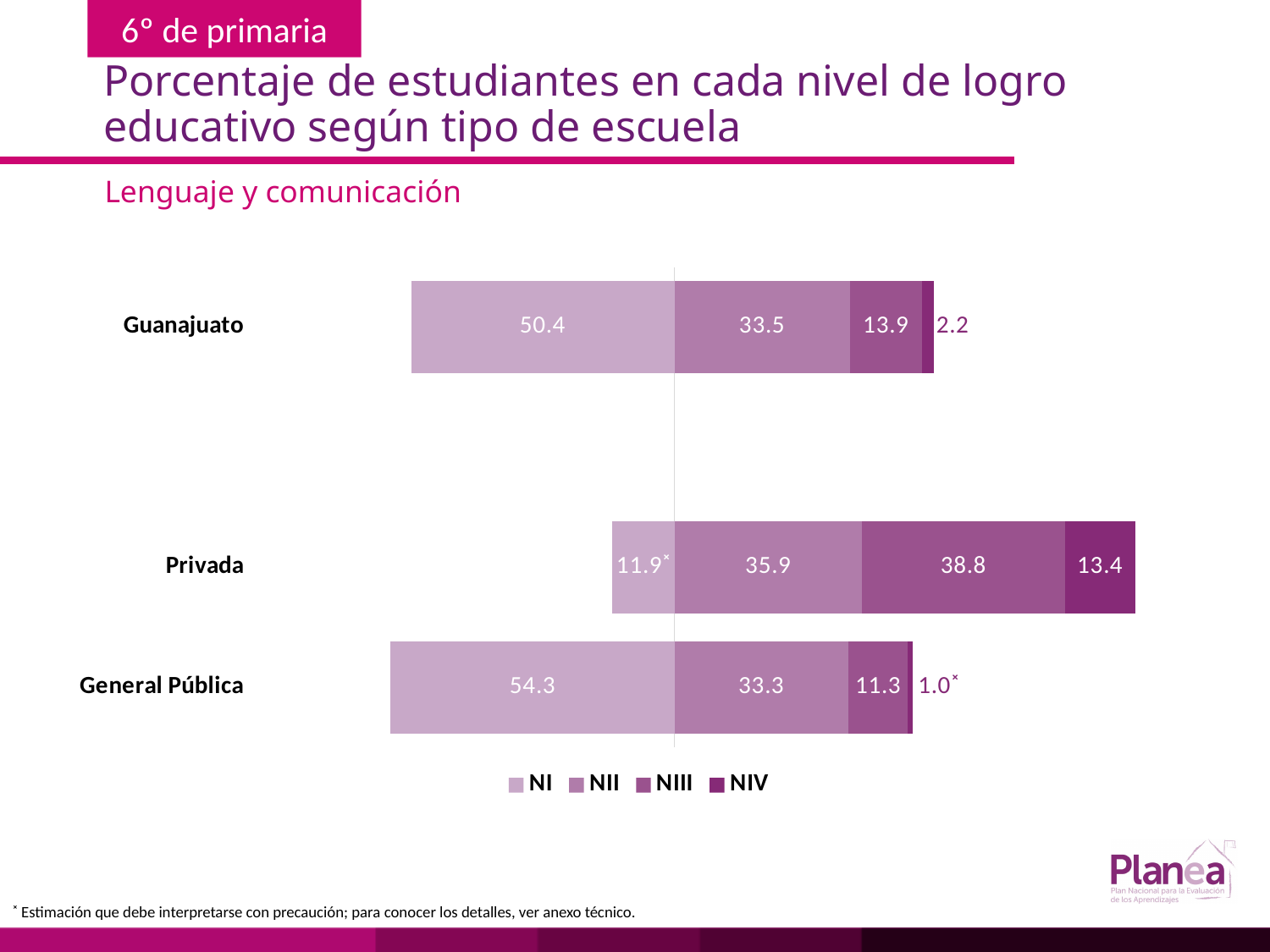
Which subject area does the chart cover, according to the subtitle? Lenguaje y comunicación What is the NIII value for General Pública? 11.3 Which is larger, the NIII value for Privada or the NIII value for Guanajuato? Privada What kind of chart is shown on the slide? Stacked bar chart Which school type has the highest NI value? General Pública Which category has the lowest NIV value? General Pública What percentage of Guanajuato students are at level NI? 50.4 What is the difference between the NI values for General Pública and Privada? 42.4 What is the total of the stacked bar for Guanajuato? 100.0 How many categories (school types) are shown in the chart? 3 What is the NIV value for Privada schools? 13.4 How many series does the legend list? 4